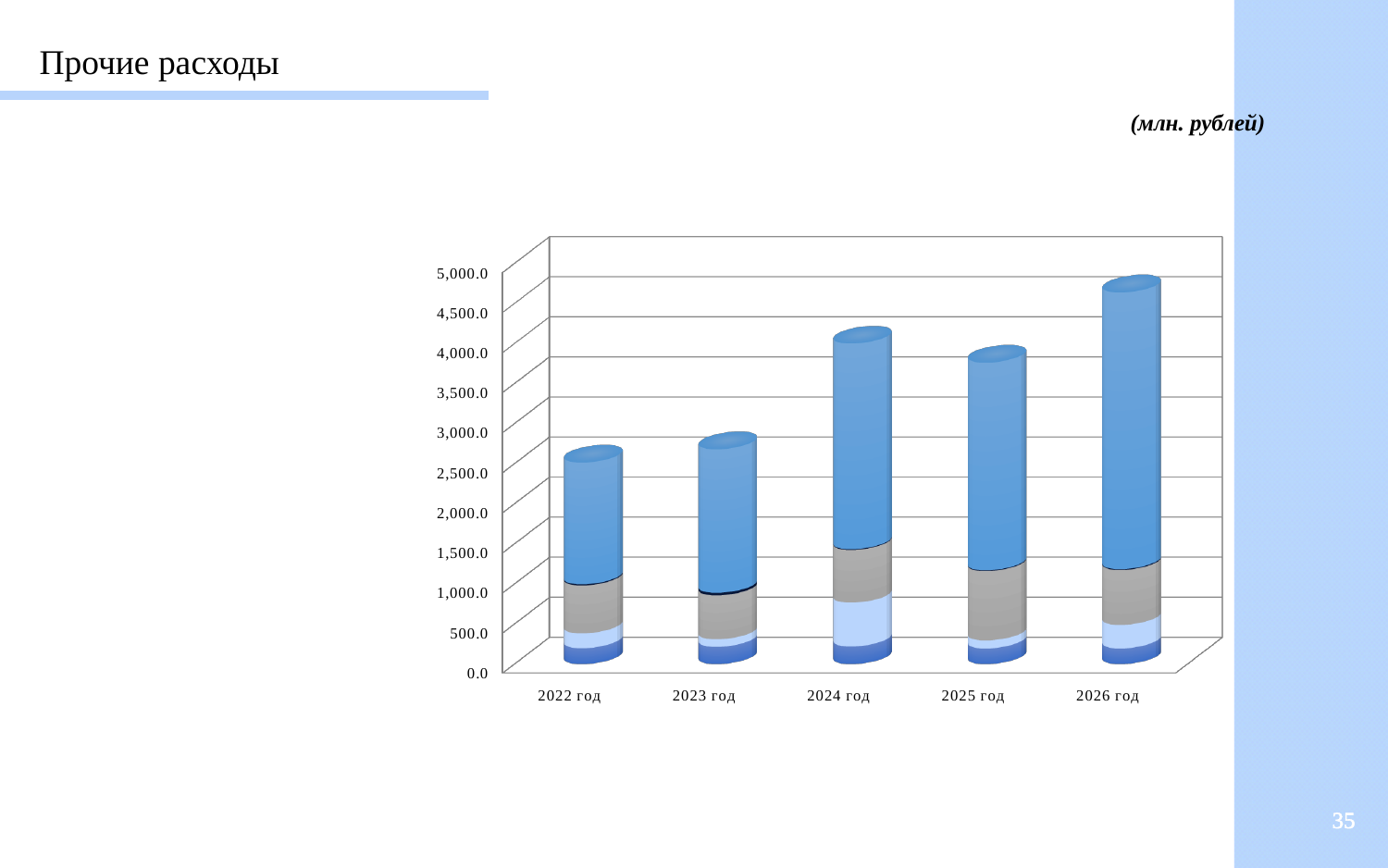
Is the total for 2022 год greater or less than 3,000.0? less Is the total for 2025 год greater or less than 3,000.0? greater Is the total for 2026 год greater or less than 4,000.0? greater How many years (categories) are shown on the x axis? 5 What is the title of the slide containing the chart? Прочие расходы Do the total values rise or fall from 2022 год to 2024 год? rise Which year has the highest total bar? 2026 год What kind of chart is shown on the slide? Stacked bar chart In what units are the chart values given, according to the slide? млн. рублей Which is larger, the total for 2024 год or the total for 2023 год? 2024 год